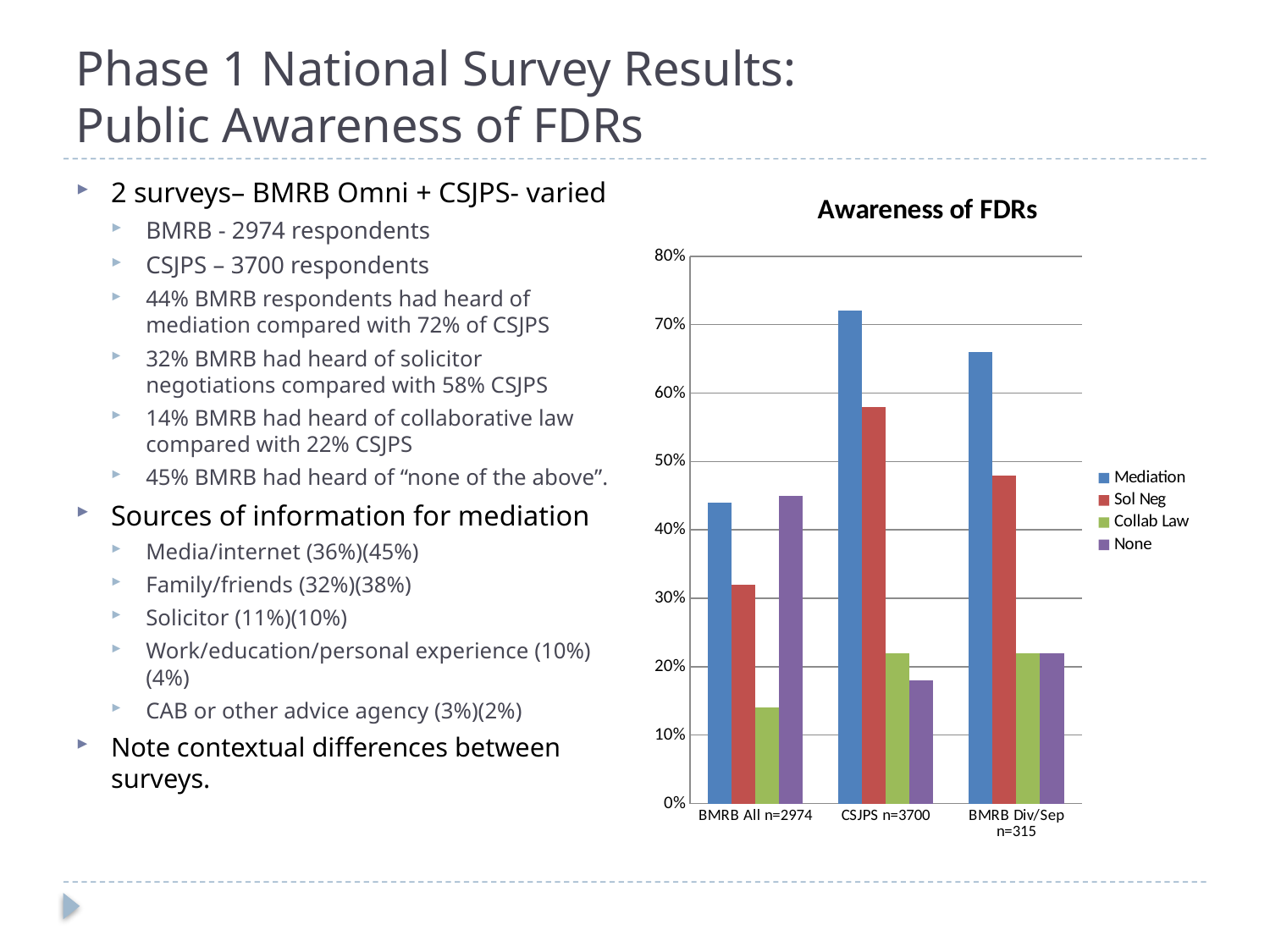
What is the title of the chart on the slide? Awareness of FDRs What is the Mediation value for CSJPS n=3700 in the Awareness of FDRs chart? 72% Is the Mediation value for BMRB Div/Sep n=315 greater or less than 60%? greater How many survey groups are shown along the x axis of the Awareness of FDRs chart? 3 What is the Sol Neg value for BMRB All n=2974 in the Awareness of FDRs chart? 32% Is the None value for CSJPS n=3700 greater or less than 20%? less How many series does the legend of the Awareness of FDRs chart list? 4 By how much does the Mediation value for CSJPS n=3700 exceed the Mediation value for BMRB All n=2974? 28% Which series has the lowest bar for BMRB All n=2974 in the Awareness of FDRs chart? Collab Law Which survey group has the highest Mediation bar in the Awareness of FDRs chart? CSJPS n=3700 What kind of chart is shown on the slide? bar chart Which is larger in the Awareness of FDRs chart: the Sol Neg value for CSJPS n=3700 or the Sol Neg value for BMRB Div/Sep n=315? CSJPS n=3700